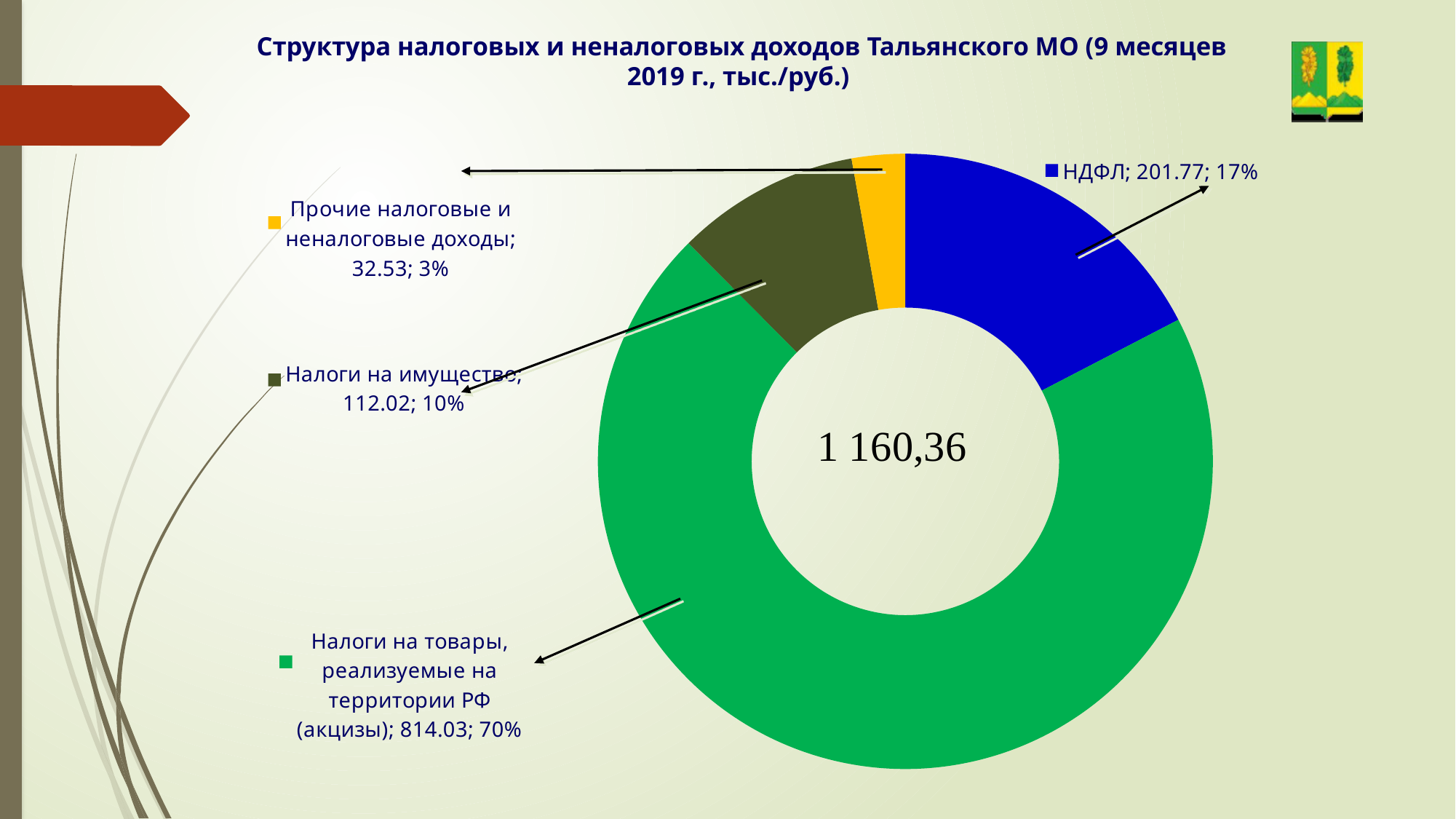
What share of the total do Налоги на товары, реализуемые на территории РФ (акцизы) represent? 70% What share of the total does НДФЛ represent? 17% What is the value for Налоги на товары, реализуемые на территории РФ (акцизы)? 814.03 What is the difference between the values for НДФЛ and Налоги на имущество? 89.75 Which category has the largest slice? Налоги на товары, реализуемые на территории РФ (акцизы) What is the value for НДФЛ? 201.77 What is the value for Налоги на имущество? 112.02 Which category has the smallest slice? Прочие налоговые и неналоговые доходы What kind of chart is shown on the slide? Doughnut (pie) chart What is the value for Прочие налоговые и неналоговые доходы? 32.53 Which is larger, НДФЛ or Налоги на имущество? НДФЛ How many categories does the chart show? 4